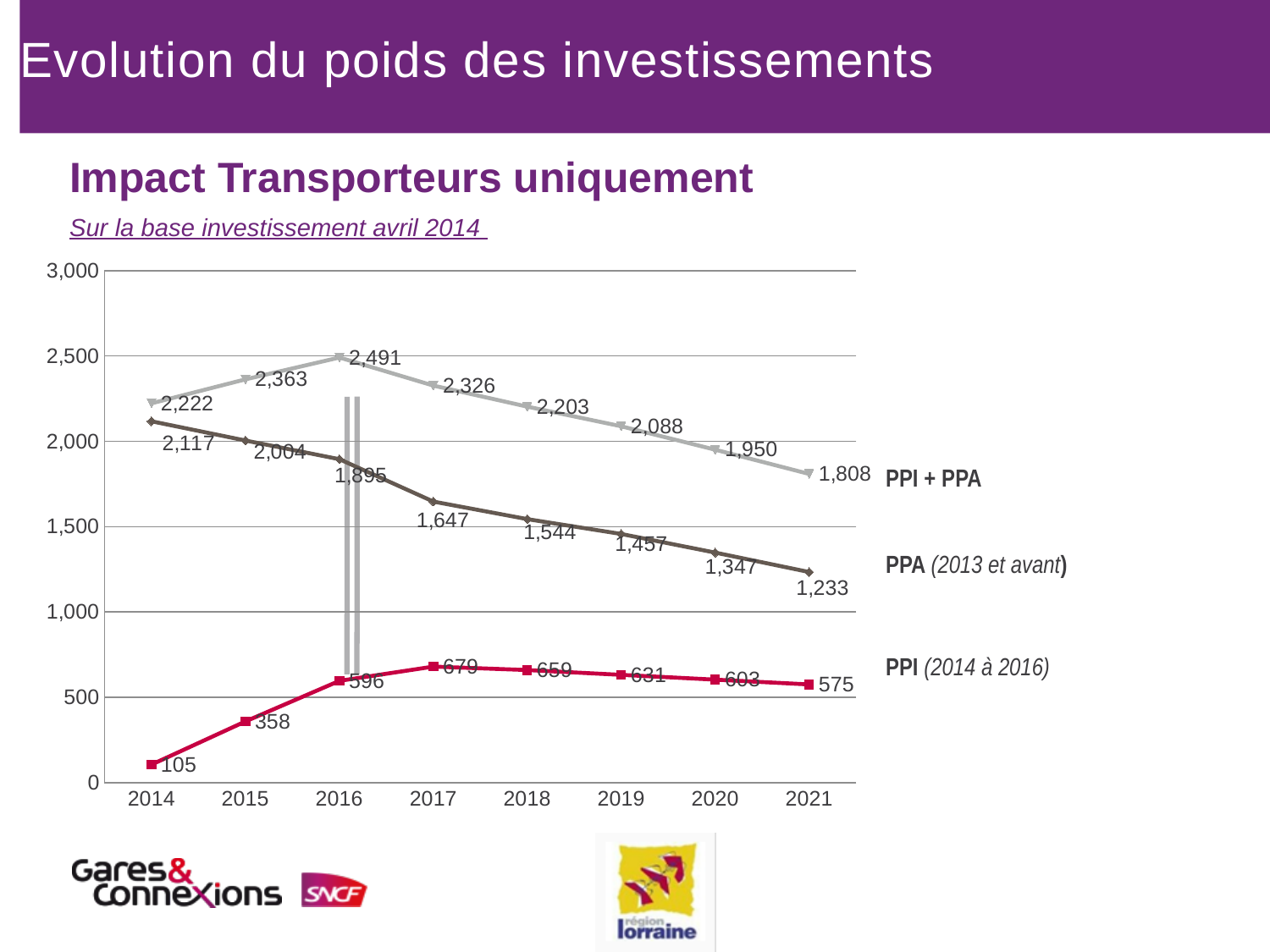
What type of chart is shown on the slide? line chart Which is larger in 2017: the PPA (2013 et avant) value or the PPI (2014 à 2016) value? PPA (2013 et avant) What is the value of the PPI (2014 à 2016) series in 2014? 105 What is the value of the PPI + PPA series in 2016? 2,491 How many years are plotted on the x axis? 8 What is the difference between the PPI + PPA values in 2014 and 2021? 414 In which year does the PPI + PPA series reach its highest value? 2016 What is the subtitle written above the chart? Sur la base investissement avril 2014 How many series are plotted on the chart? 3 In which year is the PPI (2014 à 2016) series at its lowest? 2014 Does the PPA (2013 et avant) series rise or fall from 2014 to 2021? fall What is the value of the PPA (2013 et avant) series in 2021? 1,233